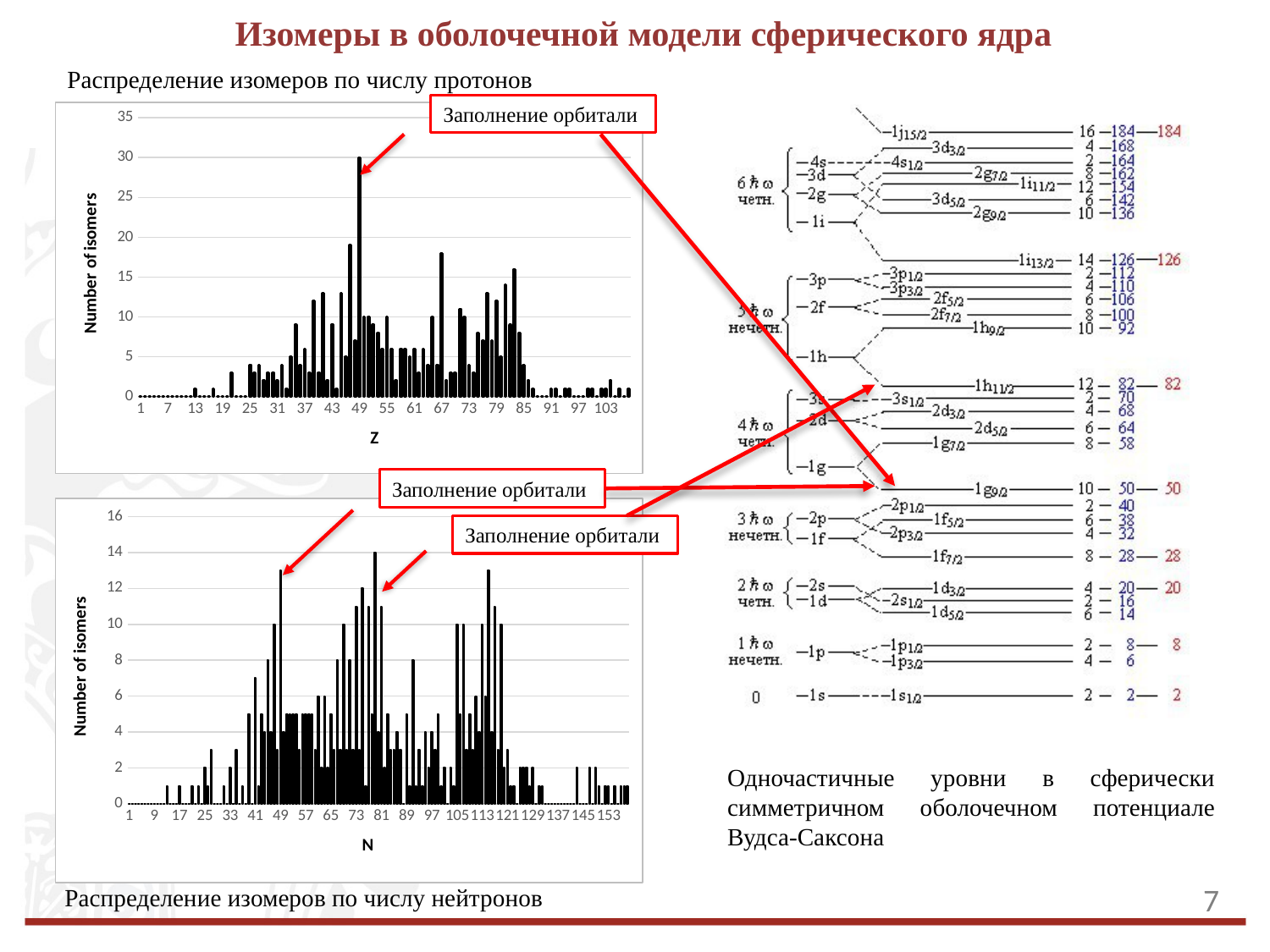
In the bottom chart (distribution by number of neutrons), is the value at N = 49 greater or less than 10? greater In the top chart (distribution by number of protons), is the value of the tallest bar greater or less than 25? greater In the bottom chart (distribution by number of neutrons), is the value of the tallest bar greater or less than 12? greater Which of the two bar charts has the larger maximum value on its vertical axis: the top chart (by protons) or the bottom chart (by neutrons)? the top chart (by protons) In the top chart (distribution by number of protons), which bar is taller: the one at Z = 49 or the one at Z = 67? Z = 49 What kind of chart is the bottom chart, 'Распределение изомеров по числу нейтронов'? bar chart What kind of chart is the top chart, 'Распределение изомеров по числу протонов'? bar chart In the bottom chart (distribution by number of neutrons), what is the label of the horizontal axis? N In the top chart (distribution by number of protons), what is the label of the horizontal axis? Z